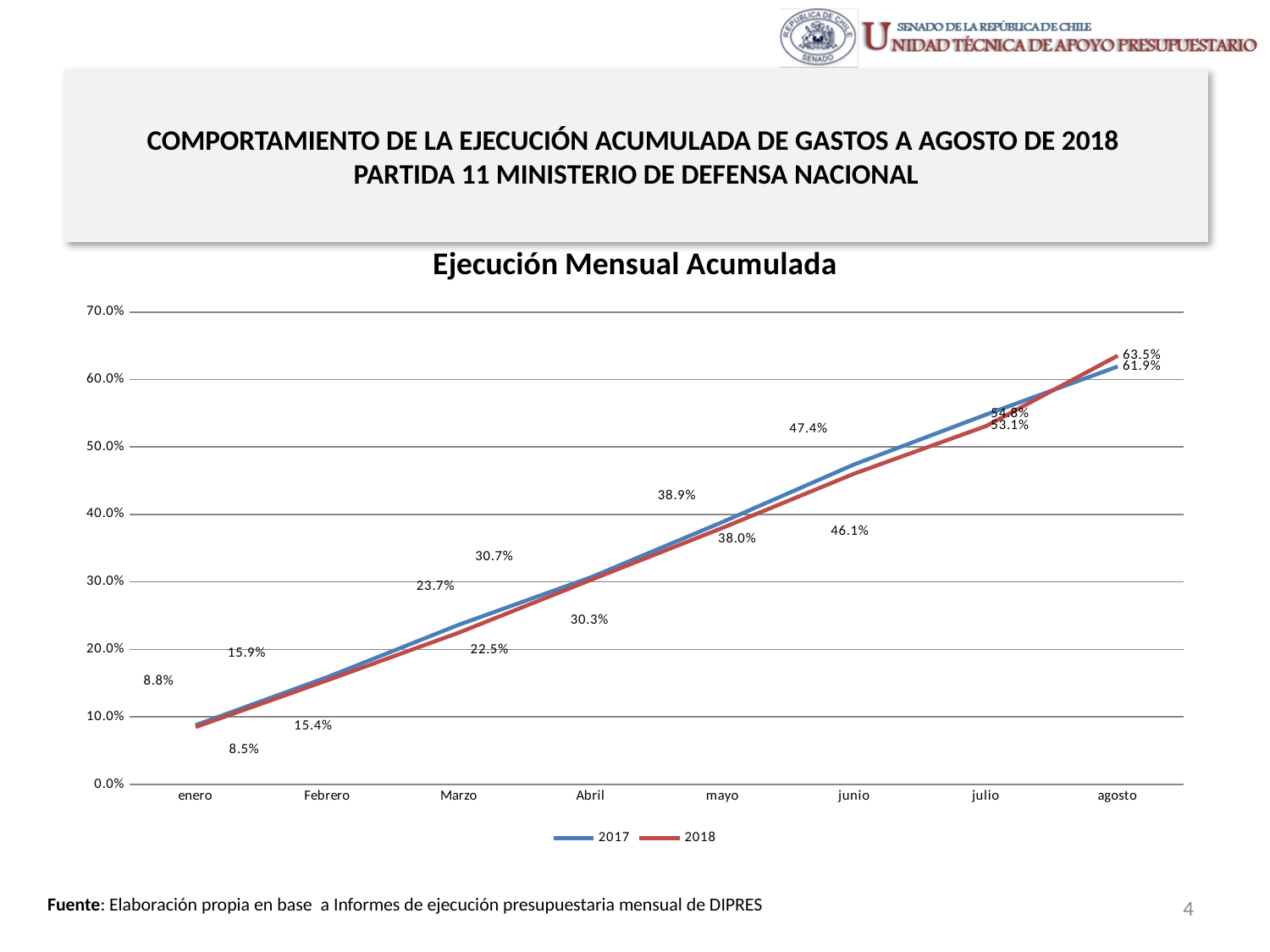
In julio, which series has the larger value, 2017 or 2018? 2017 What is the value for 2018 in enero? 8.5% In which month does the 2018 series reach its highest value? agosto What is the value for 2018 in agosto? 63.5% What is the value for 2017 in enero? 8.8% What is the title of the chart? Ejecución Mensual Acumulada How many series does the legend list? 2 What is the value for 2017 in agosto? 61.9% How many months are plotted along the x axis? 8 Do the values for 2018 rise or fall from enero to agosto? rise What is the difference between the 2018 and 2017 values in agosto? 1.6 percentage points What kind of chart is shown on the slide? line chart